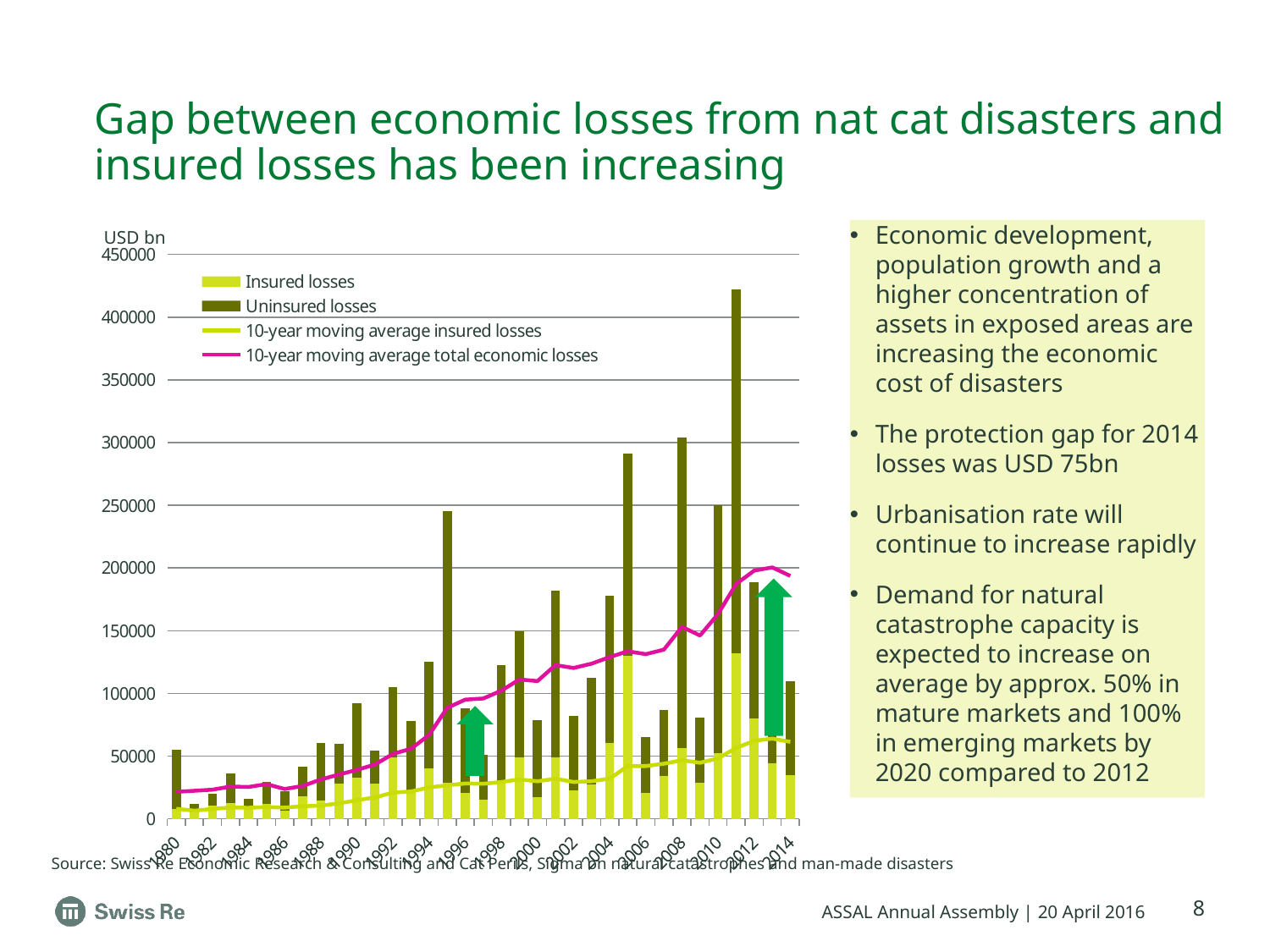
How many series does the chart legend list? 4 Is the total bar for 1980 greater or less than 100000? less How many years are labeled on the x axis of the chart? 18 Is the total bar for 2014 greater or less than 150000? less Is the total bar for 2012 greater or less than 150000? greater What colour is the line for the 10-year moving average total economic losses? pink What unit is shown above the y axis of the chart? USD bn Which year has the larger total bar, 2008 or 2014? 2008 What kind of chart is shown on the slide? combination bar and line chart Does the 10-year moving average total economic losses line generally rise or fall from 1980 to 2014? rise